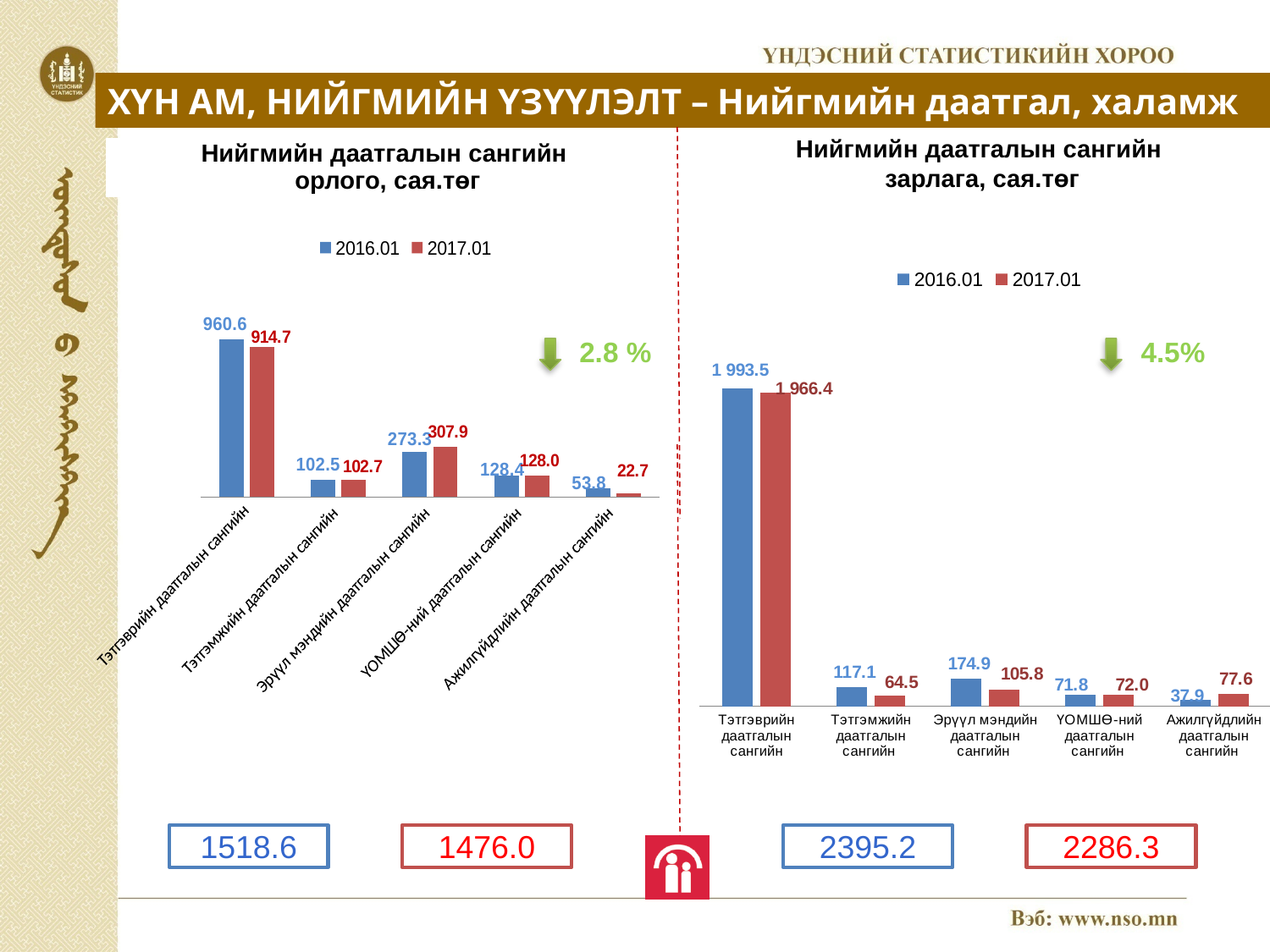
In the chart titled 'Нийгмийн даатгалын сангийн орлого, сая.төг', which category has the lowest value in 2017.01? Ажилгүйдлийн даатгалын сангийн In the chart titled 'Нийгмийн даатгалын сангийн орлого, сая.төг', what is the difference between the 2016.01 and 2017.01 values for Ажилгүйдлийн даатгалын сангийн? 31.1 In the chart titled 'Нийгмийн даатгалын сангийн зарлага, сая.төг', what is the value for Тэтгэмжийн даатгалын сангийн in 2017.01? 64.5 In the chart titled 'Нийгмийн даатгалын сангийн зарлага, сая.төг', which category has the highest value in 2016.01? Тэтгэврийн даатгалын сангийн In the chart titled 'Нийгмийн даатгалын сангийн зарлага, сая.төг', what is the value for Ажилгүйдлийн даатгалын сангийн in 2016.01? 37.9 In the chart titled 'Нийгмийн даатгалын сангийн зарлага, сая.төг', which is larger for Эрүүл мэндийн даатгалын сангийн: the 2016.01 value or the 2017.01 value? 2016.01 In the chart titled 'Нийгмийн даатгалын сангийн зарлага, сая.төг', what is the difference between the 2016.01 and 2017.01 values for Эрүүл мэндийн даатгалын сангийн? 69.1 What kind of chart is the chart titled 'Нийгмийн даатгалын сангийн орлого, сая.төг'? Bar chart How many categories are shown in the chart titled 'Нийгмийн даатгалын сангийн зарлага, сая.төг'? 5 In the chart titled 'Нийгмийн даатгалын сангийн орлого, сая.төг', what is the value for Эрүүл мэндийн даатгалын сангийн in 2017.01? 307.9 In the chart titled 'Нийгмийн даатгалын сангийн орлого, сая.төг', how many series does the legend list? 2 In the chart titled 'Нийгмийн даатгалын сангийн орлого, сая.төг', what is the value for Тэтгэврийн даатгалын сангийн in 2016.01? 960.6